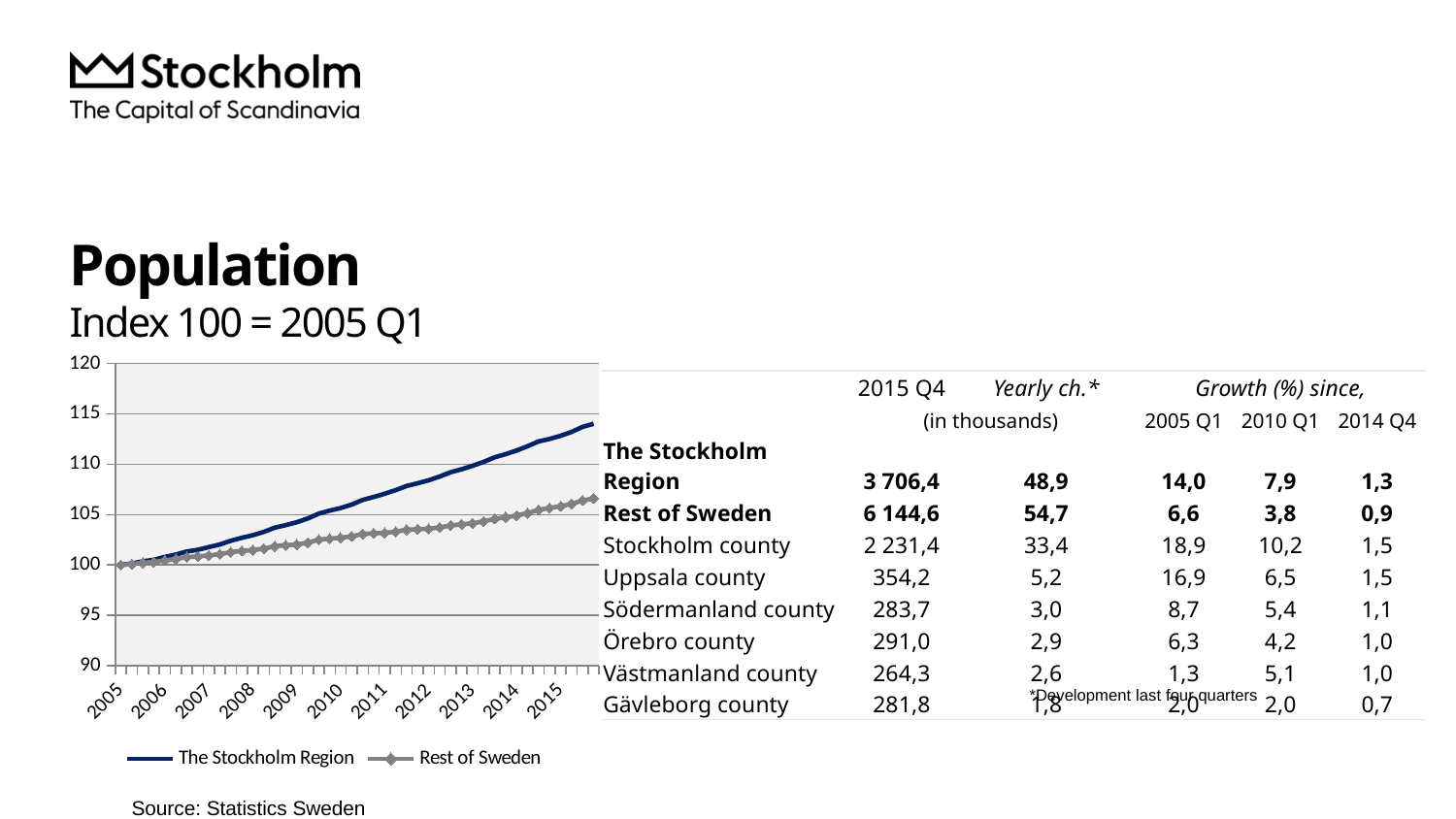
How many series does the chart's legend list? 2 Is the index value for The Stockholm Region at the end of 2015 greater or less than 110? greater Does the index for The Stockholm Region rise or fall from 2005 to 2015? Rise Is the index value for Rest of Sweden at the end of 2015 greater or less than 110? less Which two series are plotted in the chart? The Stockholm Region and Rest of Sweden Is the index value for Rest of Sweden in 2010 greater or less than 105? less Which series has the higher index value at the end of the chart in 2015? The Stockholm Region What is the base period for the index of 100 in the chart? 2005 Q1 Does the index for Rest of Sweden rise or fall over the period shown? Rise What is the lowest value shown on the chart's vertical axis? 90 What kind of chart is shown on the slide? Line chart